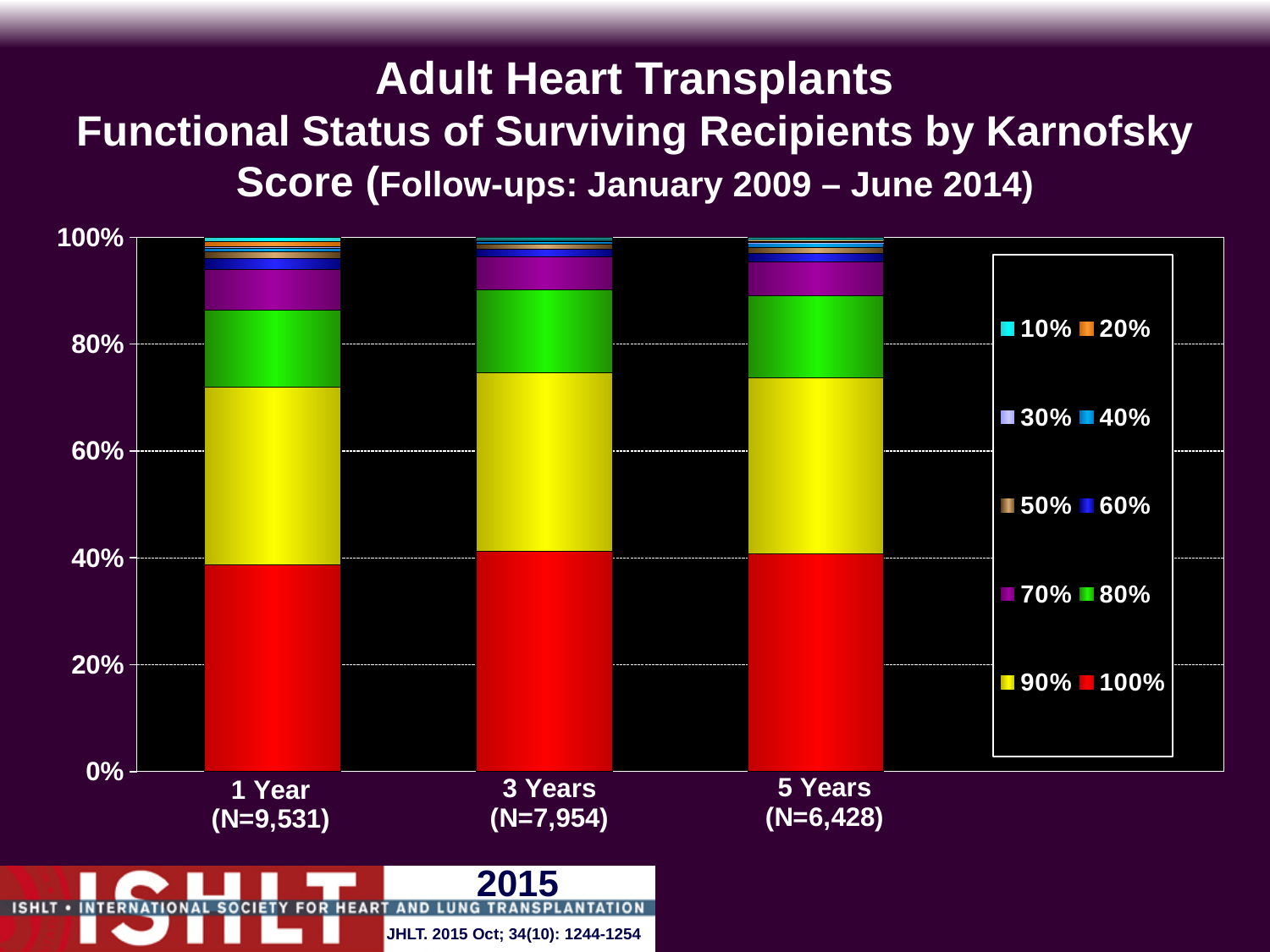
What is the sample size (N) shown for the 1 Year category? N=9,531 Which colour represents the 100% Karnofsky score in the legend? red Is the cumulative top of the 90% Karnofsky score segment for 1 Year greater or less than 60%? greater What kind of chart is shown on the slide? stacked bar chart Is the share of the 100% Karnofsky score segment for 1 Year greater or less than 20%? greater What follow-up period is stated in the chart title? January 2009 – June 2014 How many follow-up time points (categories) are plotted on the x axis? 3 What is the sample size (N) shown for the 5 Years category? N=6,428 Is the cumulative top of the 80% Karnofsky score segment for 3 Years greater or less than 80%? greater What is the total height of each stacked bar on the y axis? 100% How many Karnofsky score series does the legend list? 10